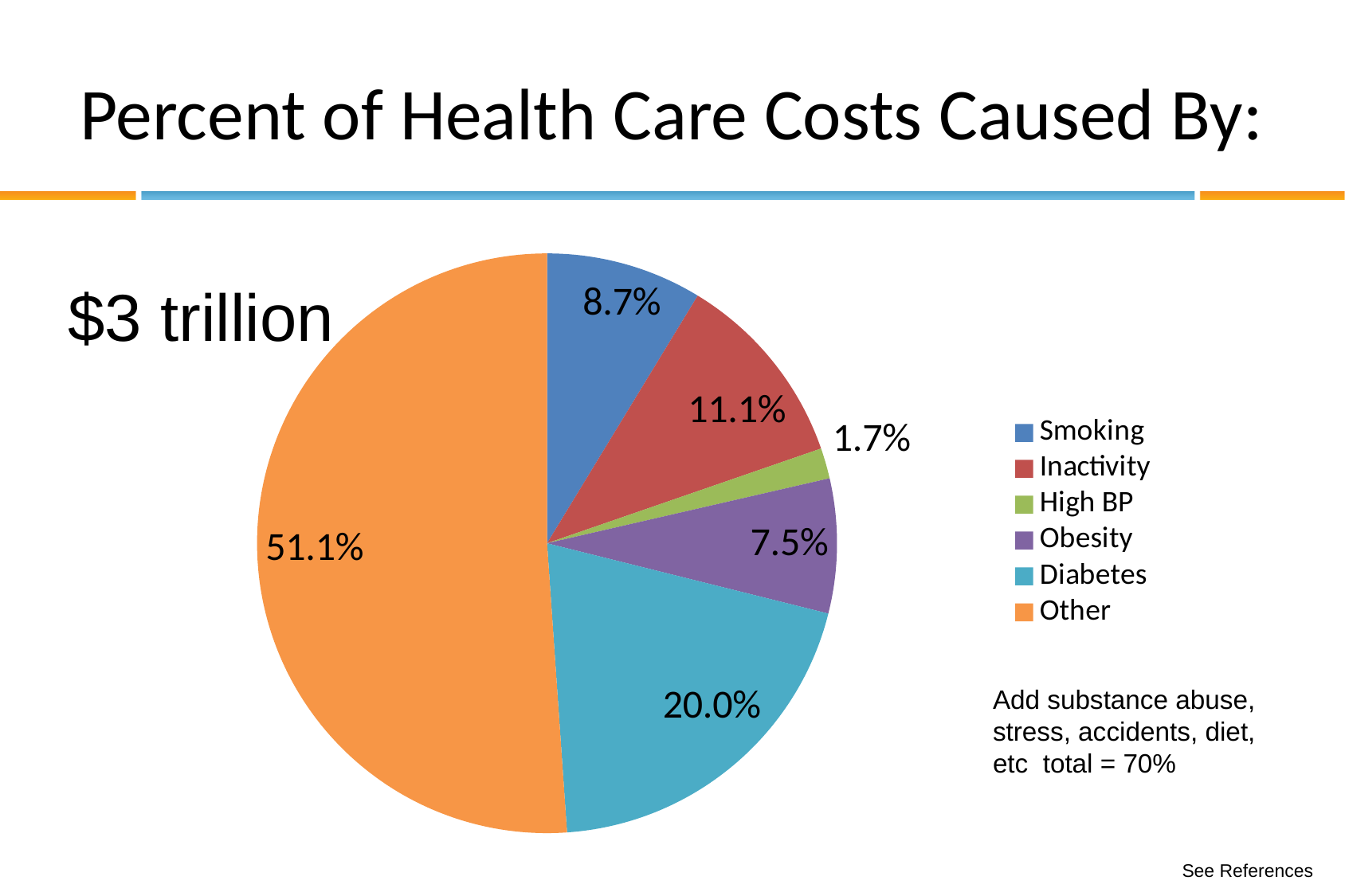
Which category accounts for the largest share of health care costs? Other Which category accounts for the smallest share of health care costs? High BP What type of chart is shown on the slide? pie chart What percentage of health care costs is attributed to Diabetes? 20.0% What percentage of health care costs is attributed to Obesity? 7.5% What percentage of health care costs is attributed to High BP? 1.7% What colour is the Diabetes slice in the pie chart? teal How many categories does the pie chart show? 6 What percentage of health care costs is attributed to Smoking? 8.7% What is the difference in percentage points between Diabetes and Inactivity? 8.9 Which is larger, the share for Smoking or the share for Obesity? Smoking What is the share of the pie for Inactivity? 11.1%